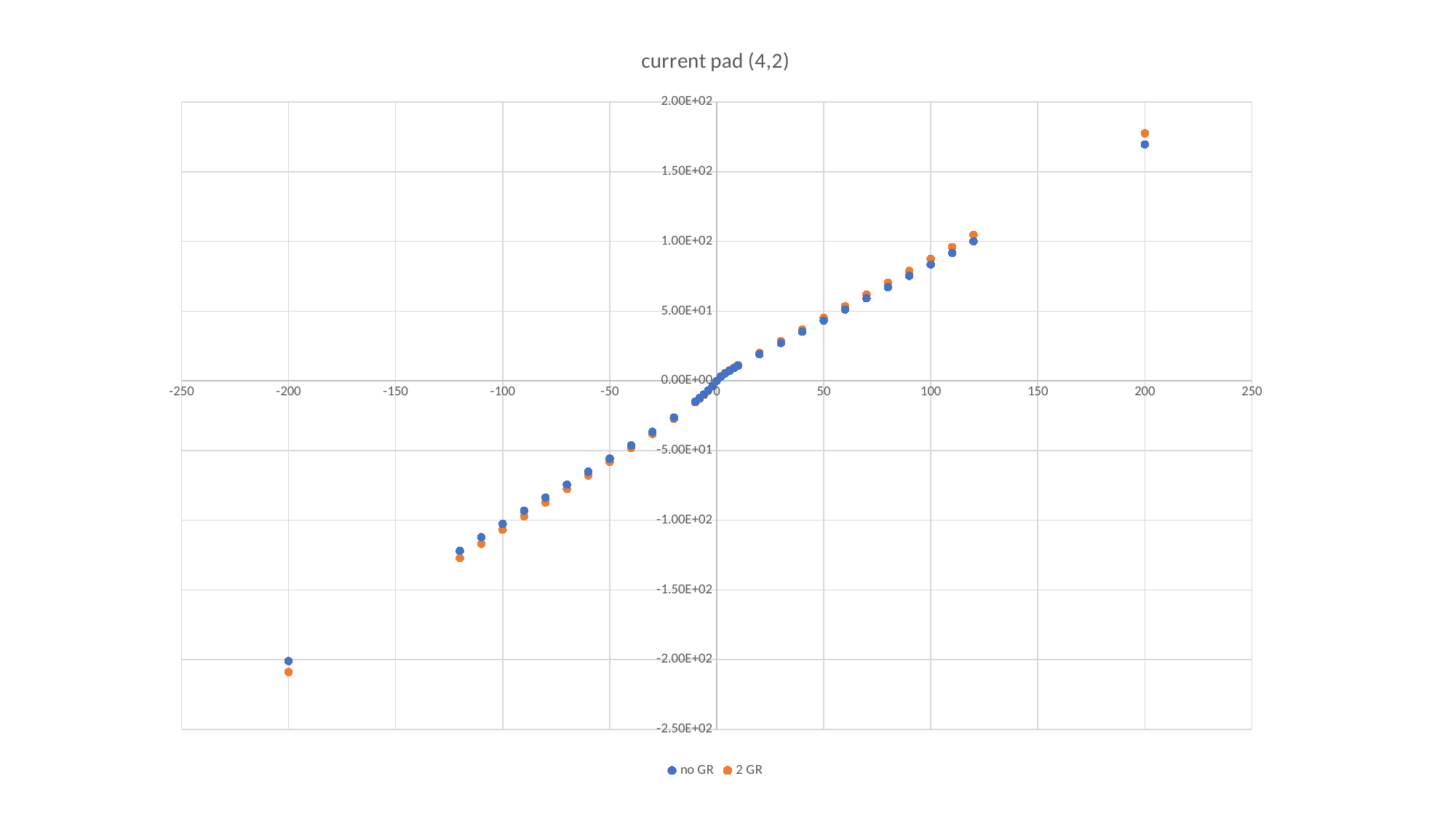
Is the "2 GR" value at x = 120 greater or less than 1.00E+02? greater What kind of chart is shown on the slide? scatter chart At x = 200, which series has the higher value, "no GR" or "2 GR"? 2 GR Which colour represents the "2 GR" series? orange Is the "2 GR" value at x = -200 greater or less than -2.00E+02? less Is the "no GR" value at x = -120 greater or less than -1.00E+02? less At x = -200, which series has the lower value, "no GR" or "2 GR"? 2 GR Do the plotted values rise or fall as the x value increases from -250 to 250? rise How many series does the legend list? 2 What is the title of the chart? current pad (4,2) At which x value do the series reach their highest plotted value? 200